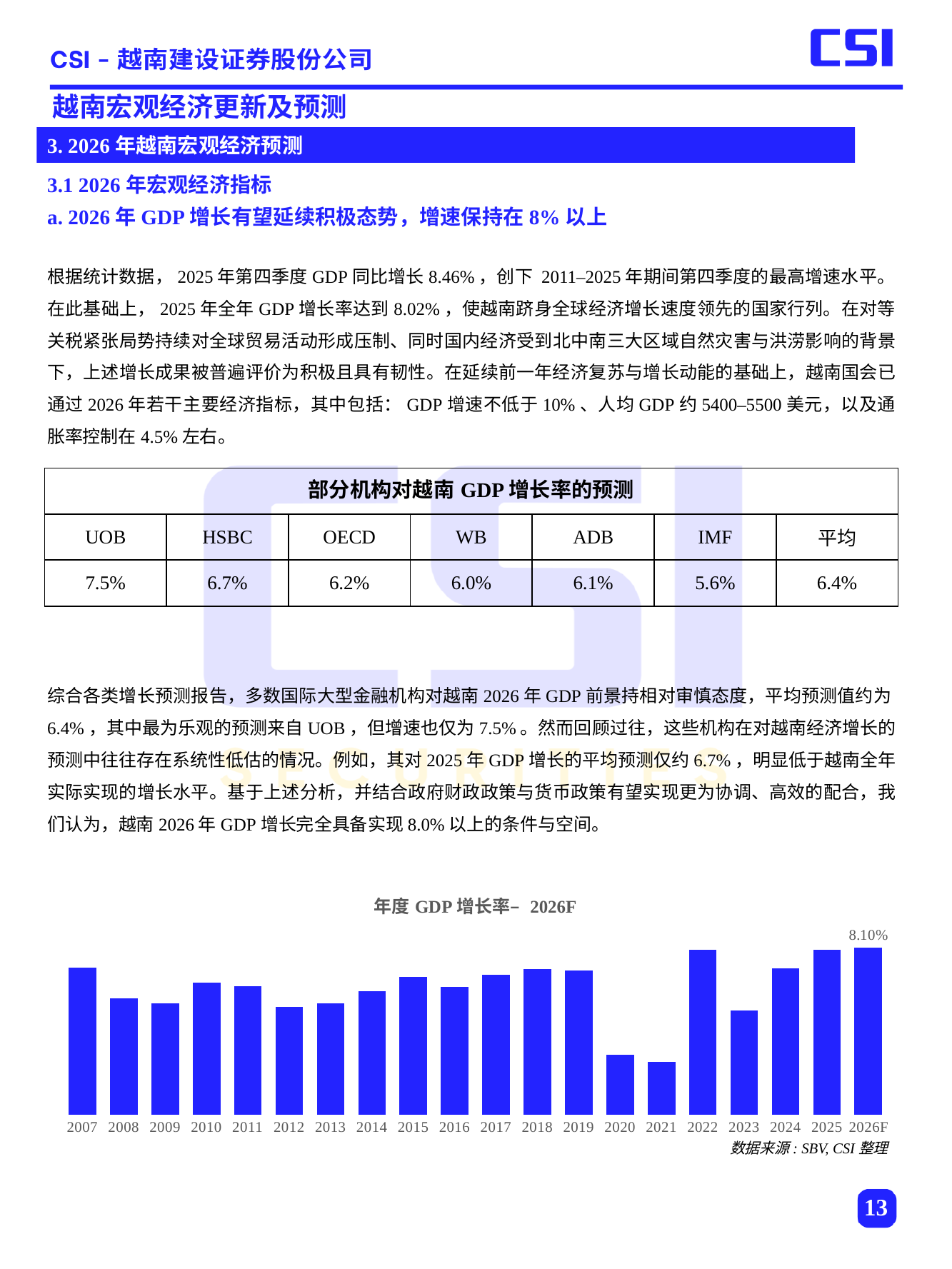
In the chart 年度 GDP 增长率– 2026F, which bar is taller, 2020 or 2021? 2020 What kind of chart is shown at the bottom of the slide? bar chart In the chart 年度 GDP 增长率– 2026F, do the values rise or fall from 2023 to 2025? rise In the chart 年度 GDP 增长率– 2026F, do the values rise or fall from 2019 to 2021? fall In the chart 年度 GDP 增长率– 2026F, which bar is taller, 2022 or 2023? 2022 In the chart 年度 GDP 增长率– 2026F, which year has the lowest bar? 2021 How many bars (years) are plotted in the chart 年度 GDP 增长率– 2026F? 20 In the chart 年度 GDP 增长率– 2026F, which bar is taller, 2007 or 2008? 2007 What is the title of the chart at the bottom of the slide? 年度 GDP 增长率– 2026F In the chart 年度 GDP 增长率– 2026F, what is the value shown for 2026F? 8.10% What data source is cited below the chart 年度 GDP 增长率– 2026F? SBV, CSI 整理